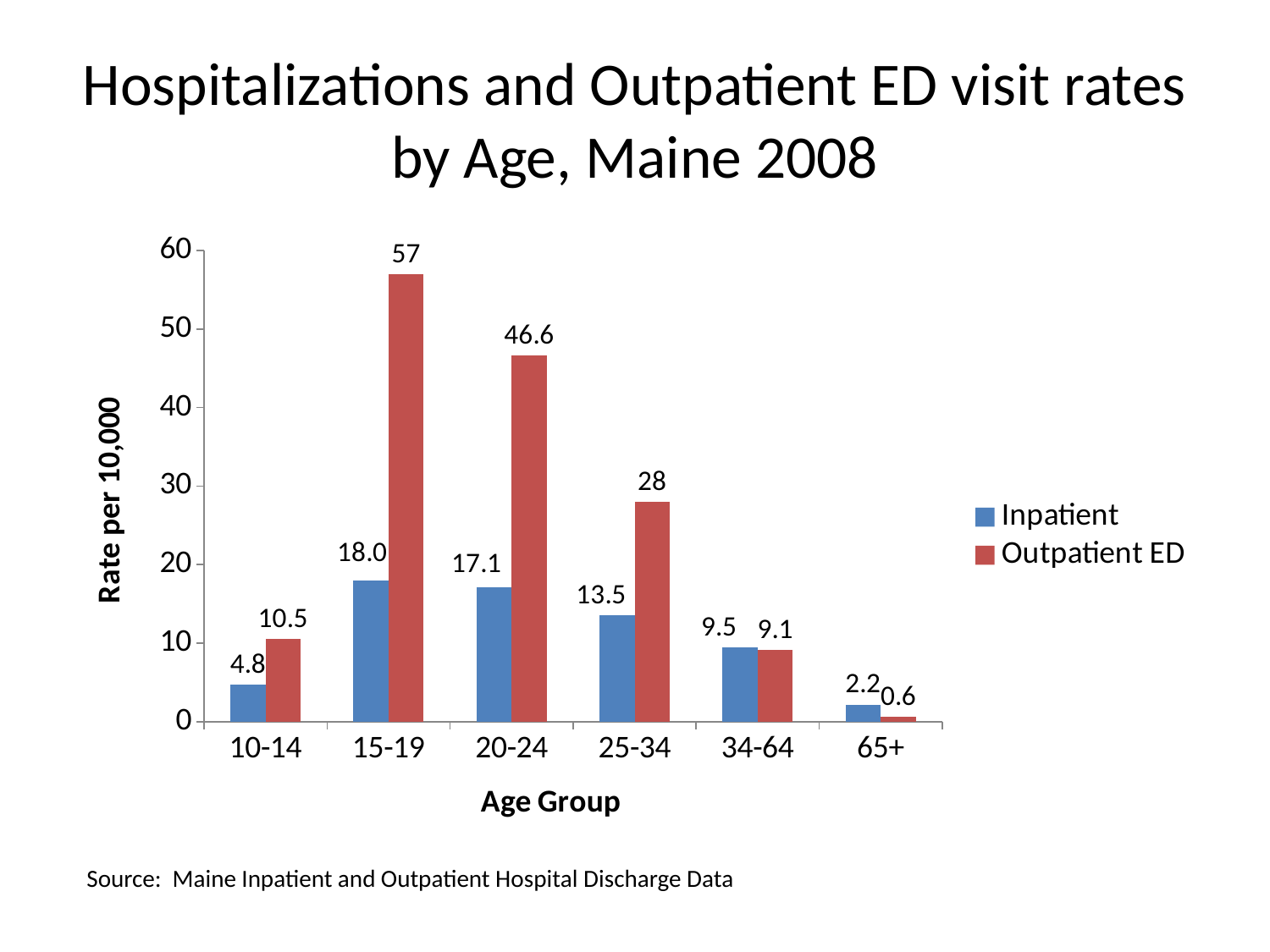
How many series does the legend list? 2 For the 34-64 age group, which is larger: the Inpatient rate or the Outpatient ED rate? Inpatient What is the label of the y axis? Rate per 10,000 Is the Outpatient ED rate for the 20-24 age group greater or less than 40? greater What is the Outpatient ED rate for the 15-19 age group? 57 What is the difference between the Outpatient ED rate and the Inpatient rate for the 25-34 age group? 14.5 Which age group has the highest Outpatient ED rate? 15-19 What is the Outpatient ED rate for the 65+ age group? 0.6 What kind of chart is shown on the slide? Bar chart What is the Inpatient rate for the 20-24 age group? 17.1 Which age group has the lowest Inpatient rate? 65+ How many age groups are shown on the x axis? 6